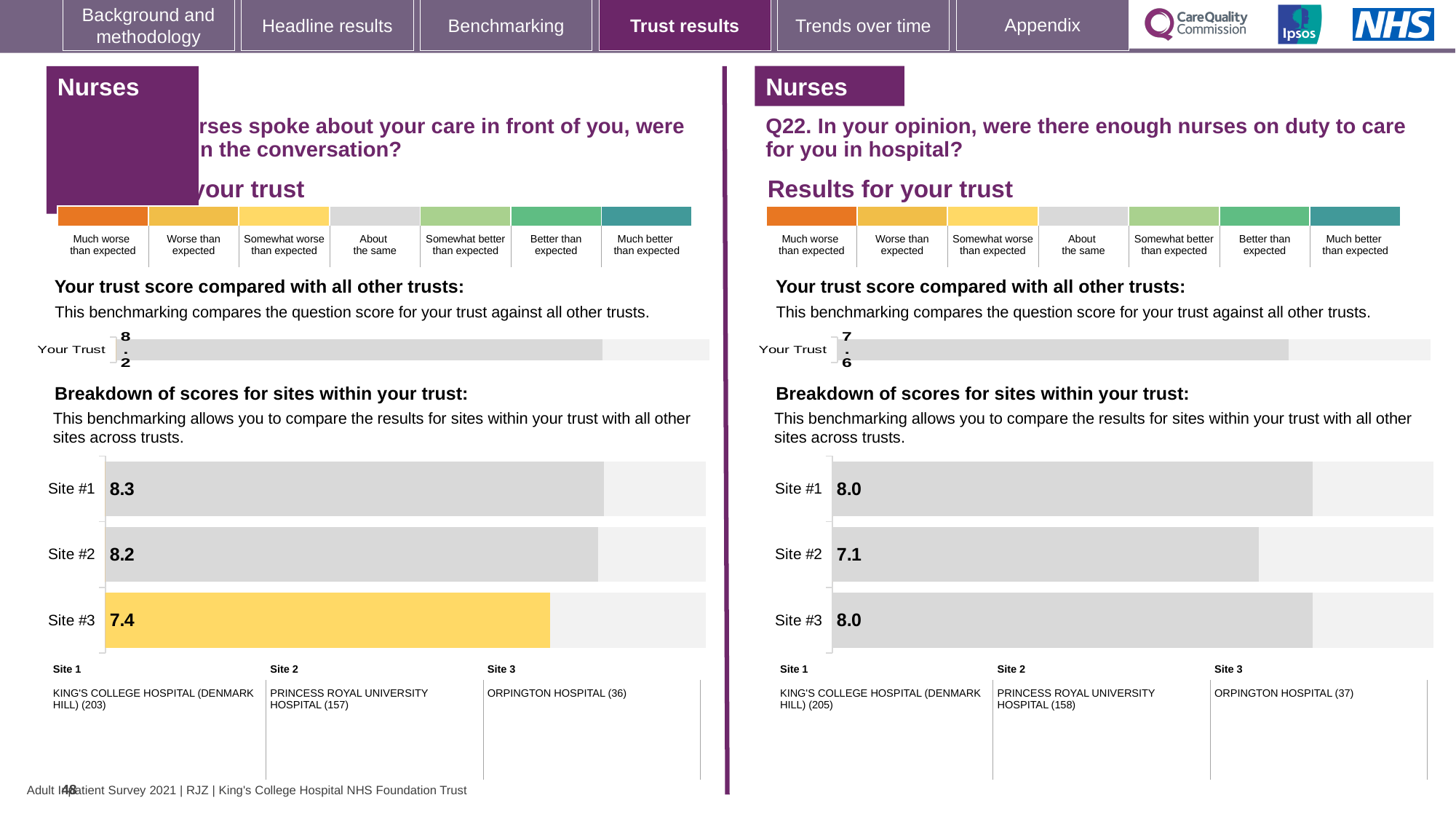
In the site breakdown chart on the left panel, how many sites are shown? 3 In the Q22 site breakdown chart on the right panel, what is the score for Site #2? 7.1 In the Q22 site breakdown chart on the right panel, what is the difference between the scores for Site #1 and Site #2? 0.9 In the Q22 site breakdown chart on the right panel, which site has the lowest score? Site #2 In the 'Your trust score compared with all other trusts' chart on the left panel, what is the score for Your Trust? 8.2 In the site breakdown chart on the left panel, what is the difference between the scores for Site #1 and Site #3? 0.9 In the site breakdown chart on the left panel, what is the score for Site #1? 8.3 In the Q22 site breakdown chart on the right panel, what is the score for Site #1? 8.0 In the site breakdown chart on the left panel, which site has the lowest score? Site #3 What type of chart is used for the site breakdown on the right panel (Q22)? Bar chart In the 'Your trust score compared with all other trusts' chart on the right panel (Q22), what is the score for Your Trust? 7.6 In the site breakdown chart on the left panel, what is the score for Site #3? 7.4